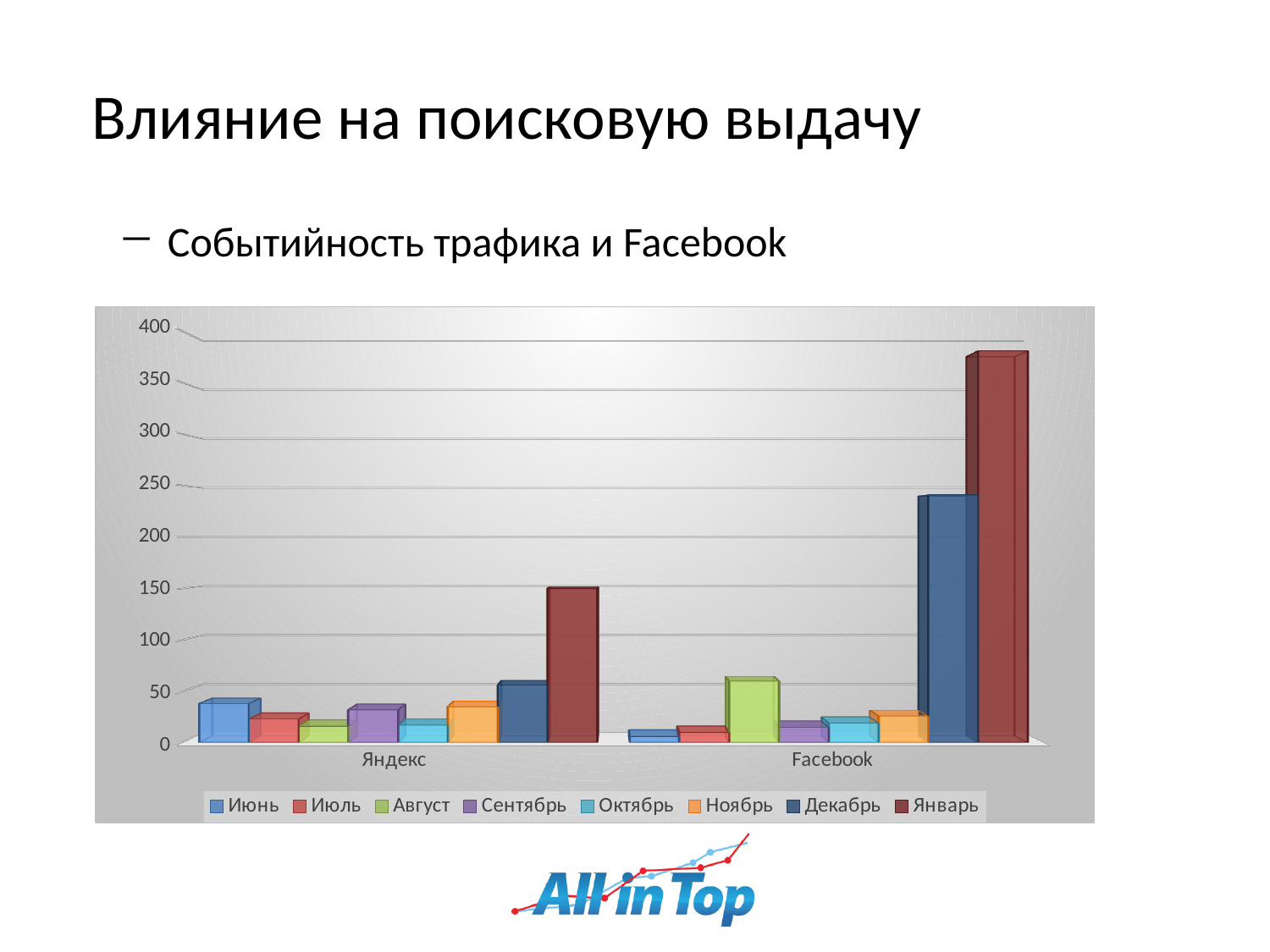
Which is larger: the Июнь value for Яндекс or the Июнь value for Facebook? Яндекс Is the value for Декабрь in the Facebook category greater or less than 200? greater Which series has the highest value for Facebook? Январь What kind of chart is shown on the slide? Bar chart Which series has the highest value for Яндекс? Январь Is the value for Июнь in the Яндекс category greater or less than 50? less Is the value for Январь in the Facebook category greater or less than 350? greater How many categories are shown on the x axis of the chart? 2 Which is larger: the Январь value for Яндекс or the Январь value for Facebook? Facebook Which series is listed first in the chart's legend? Июнь How many series does the chart's legend list? 8